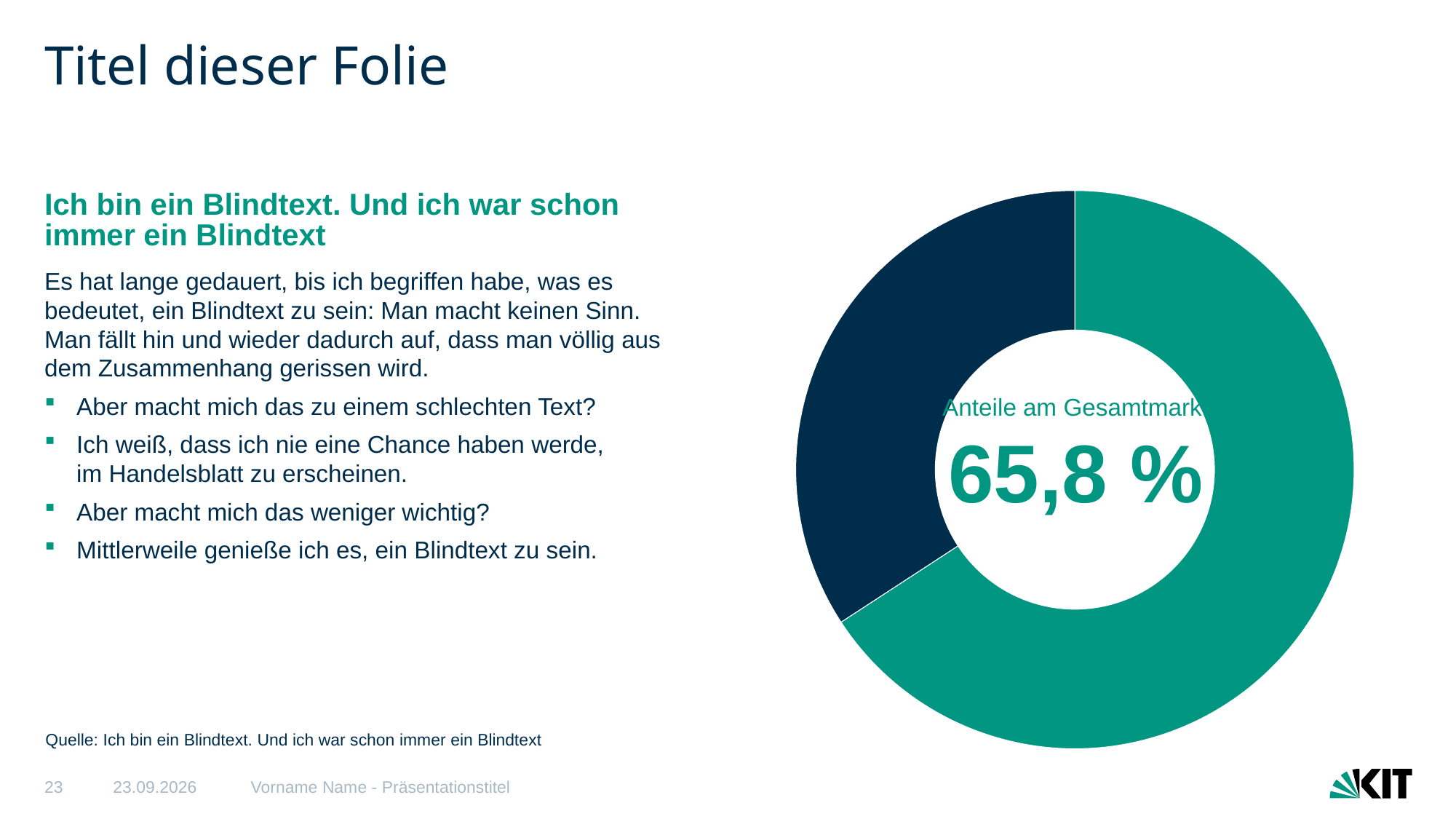
Does the donut chart have a legend? No How many slices does the donut chart have? 2 Which slice of the donut chart is the smallest? The dark navy slice What share of the donut chart does the green slice represent? 65,8 % What percentage value is printed in the centre of the donut chart? 65,8 % What kind of chart is shown on the slide? Pie chart (donut) What two colours are used for the slices of the donut chart? Green and dark navy Which slice of the donut chart is larger, the green one or the dark navy one? The green one Which slice of the donut chart is the largest? The green slice